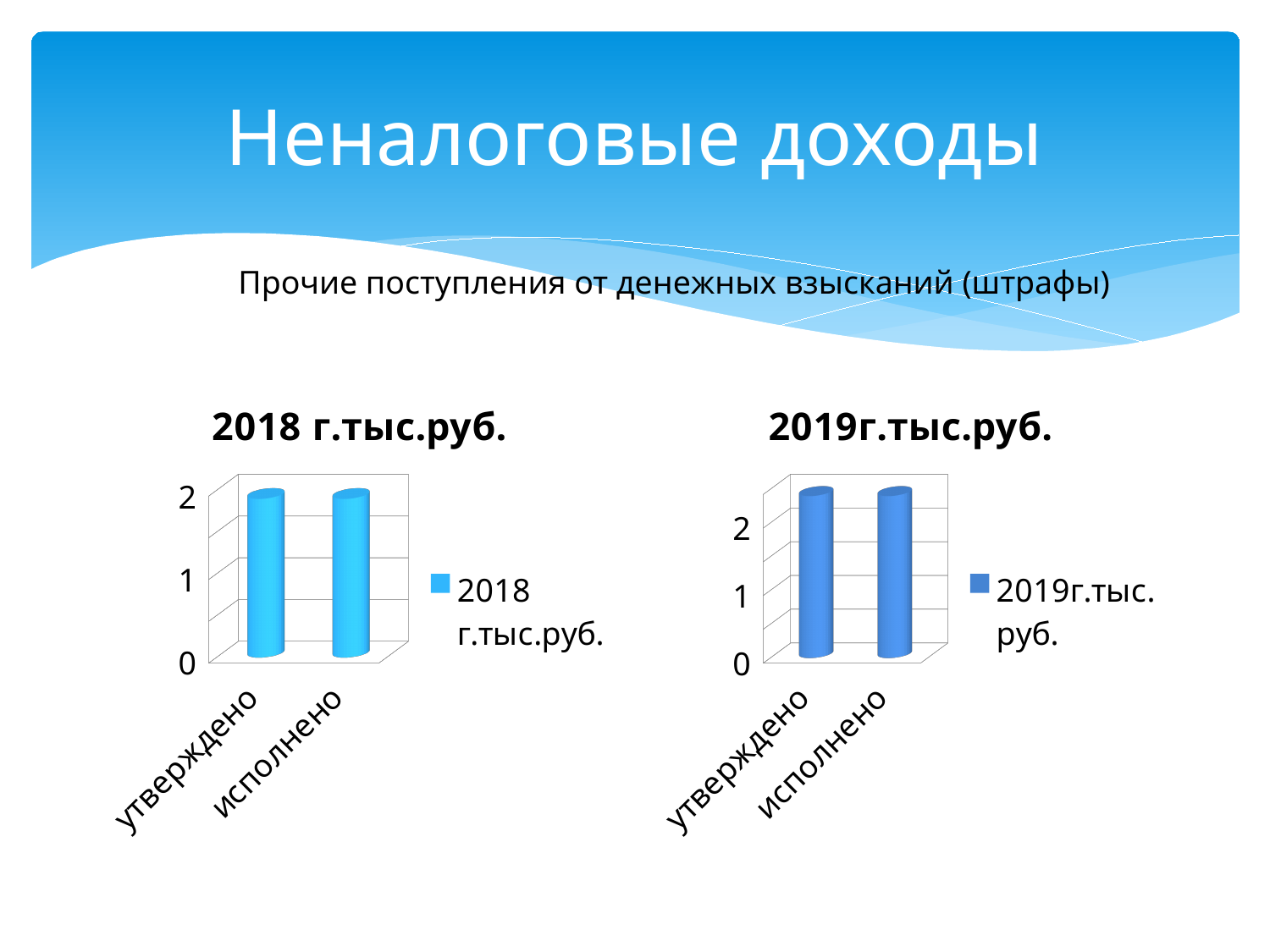
What is the title of the chart on the left side of the slide? 2018 г.тыс.руб. What series name does the legend of the chart on the right side of the slide show? 2019г.тыс.руб. In the chart titled "2018 г.тыс.руб.", is the value for исполнено greater or less than 1? greater How many series does the legend of the chart titled "2018 г.тыс.руб." list? 1 What kind of chart is the chart titled "2019г.тыс.руб."? bar chart What kind of chart is the chart titled "2018 г.тыс.руб."? bar chart How many categories are shown on the x axis of the chart titled "2019г.тыс.руб."? 2 In the chart titled "2019г.тыс.руб.", is the value for исполнено greater or less than 1? greater How many categories are shown on the x axis of the chart titled "2018 г.тыс.руб."? 2 In the chart titled "2019г.тыс.руб.", is the value for утверждено greater or less than 1? greater How many series does the legend of the chart titled "2019г.тыс.руб." list? 1